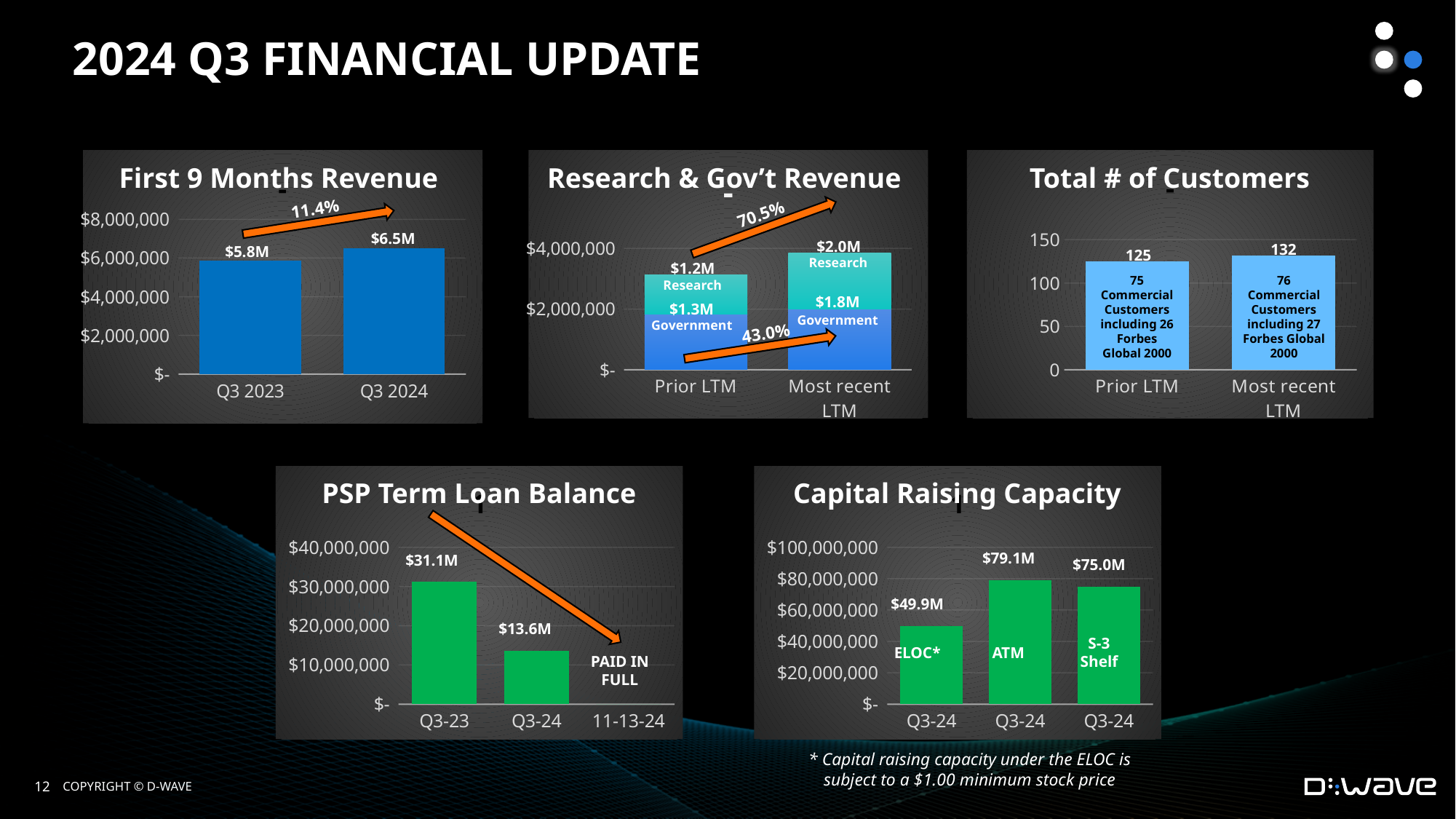
In the Research & Gov't Revenue chart, what is the total of the Most recent LTM stacked bar? $3.8M In the Total # of Customers chart, what is the difference between Most recent LTM and Prior LTM? 7 In the First 9 Months Revenue chart, what percentage growth is shown by the arrow between Q3 2023 and Q3 2024? 11.4% In the PSP Term Loan Balance chart, do the values rise or fall from Q3-23 to Q3-24? fall In the PSP Term Loan Balance chart, what is the difference between the Q3-23 and Q3-24 values? $17.5M In the First 9 Months Revenue chart, what is the value for Q3 2024? $6.5M In the Research & Gov't Revenue chart, what is the Research value for the Most recent LTM bar? $2.0M In the Total # of Customers chart, is the value for Prior LTM greater or less than 100? greater In the Capital Raising Capacity chart, which category has the highest value? ATM What kind of chart is the Capital Raising Capacity chart? bar chart In the Capital Raising Capacity chart, which category has the lowest value? ELOC* In the Research & Gov't Revenue chart, what is the total of the Prior LTM stacked bar? $2.5M